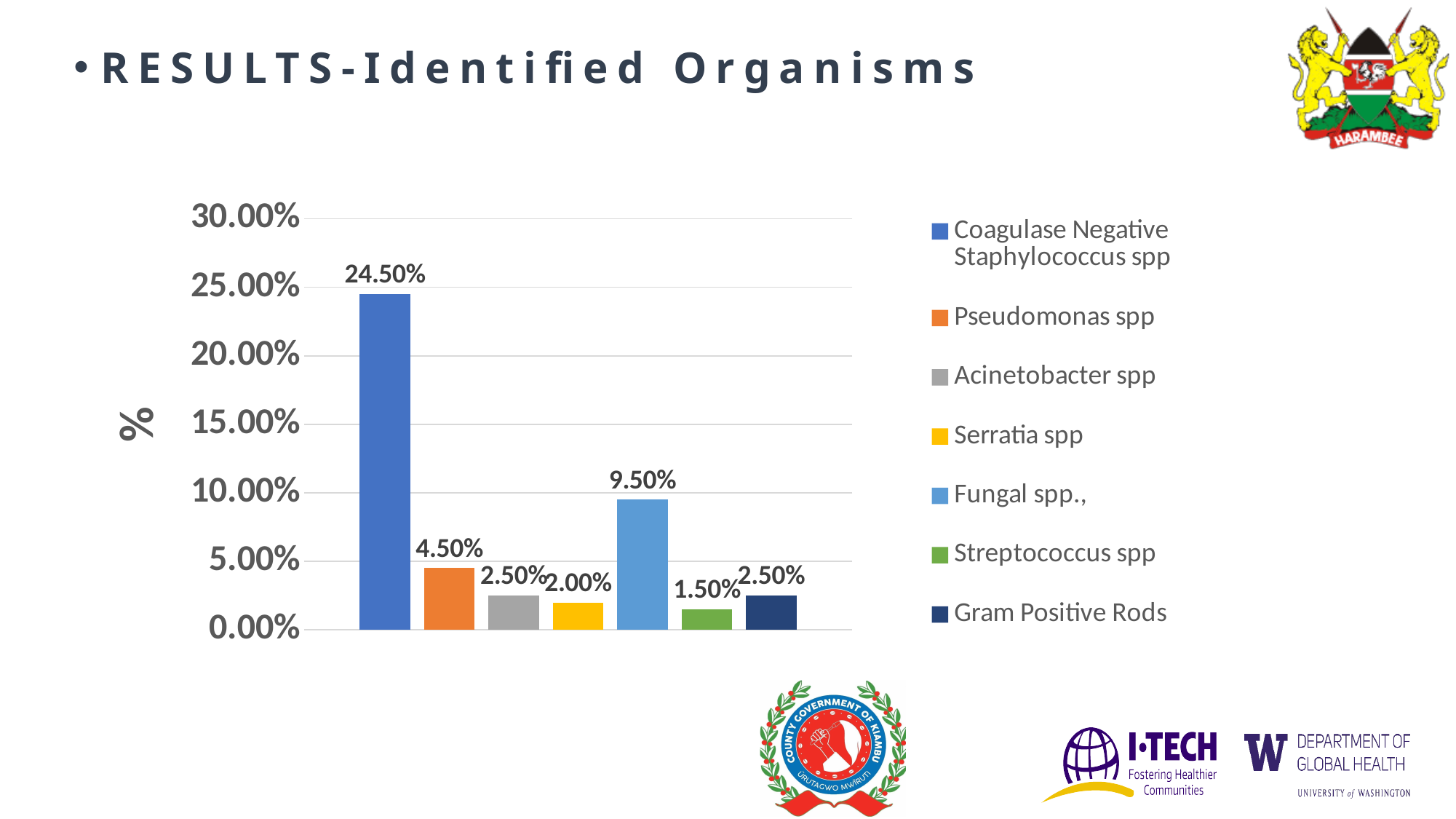
What is the value for Fungal spp.? 9.50% What is the difference between the values for Coagulase Negative Staphylococcus spp and Fungal spp.? 15.00% Which organism has the highest value? Coagulase Negative Staphylococcus spp Which is larger, the value for Pseudomonas spp or the value for Serratia spp? Pseudomonas spp What is the value for Coagulase Negative Staphylococcus spp? 24.50% Which organism has the lowest value? Streptococcus spp What is the value for Pseudomonas spp? 4.50% Is the value for Fungal spp. greater or less than 10.00%? less What is the value for Streptococcus spp? 1.50% What kind of chart is shown on the slide? Bar chart How many series does the legend list? 7 What is the label on the vertical axis? %